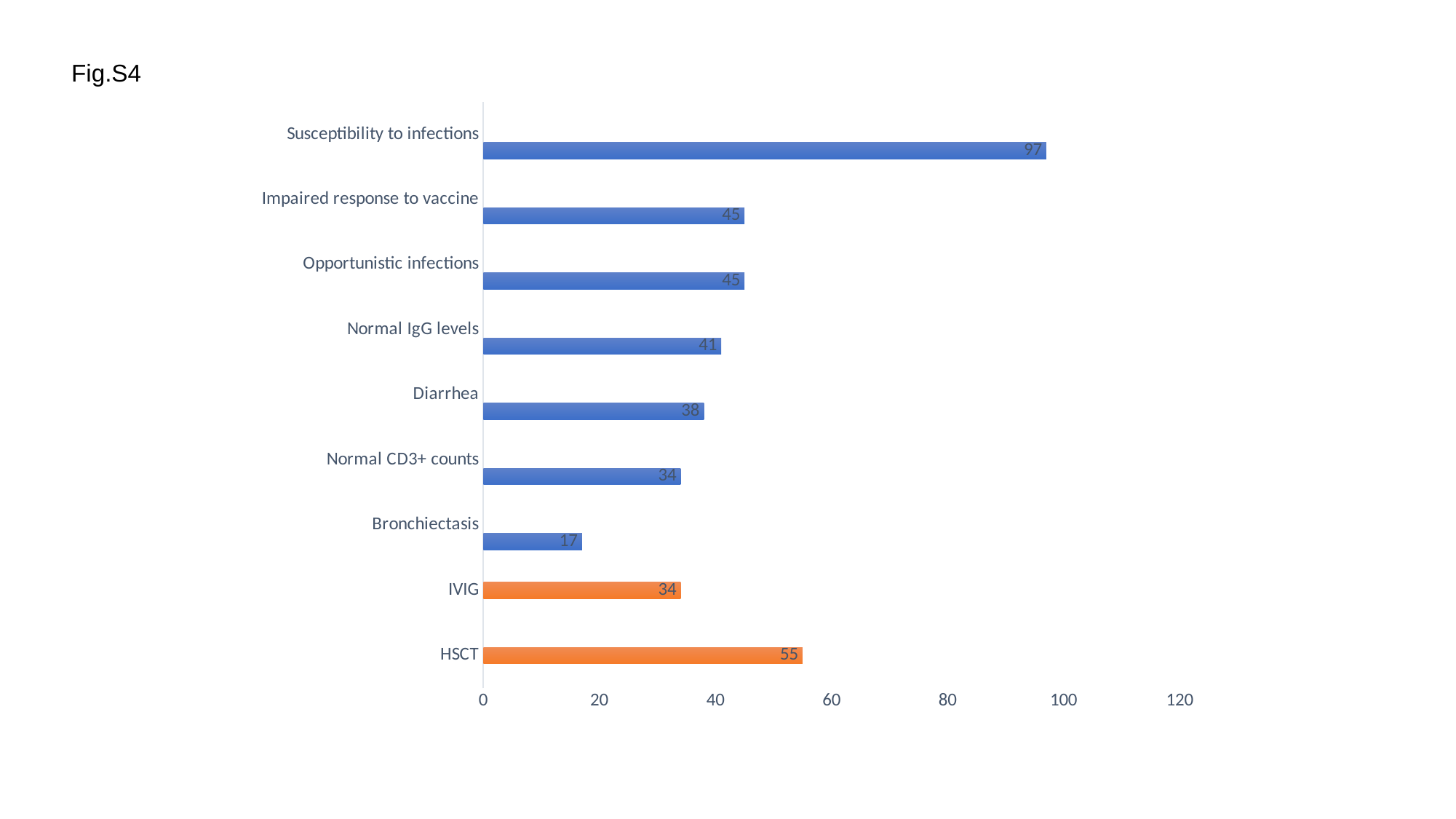
Which categories are shown with orange bars? IVIG and HSCT What kind of chart is shown on the slide? bar chart Which category has the lowest value? Bronchiectasis What is the value for Bronchiectasis? 17 What is the value for HSCT? 55 Which category has the highest value? Susceptibility to infections Is the value for Impaired response to vaccine greater or less than 40? greater What is the value for Normal IgG levels? 41 Which is larger, the value for Diarrhea or the value for Normal CD3+ counts? Diarrhea What is the difference between the values for Susceptibility to infections and HSCT? 42 What is the value for Susceptibility to infections? 97 How many categories are shown in the chart? 9